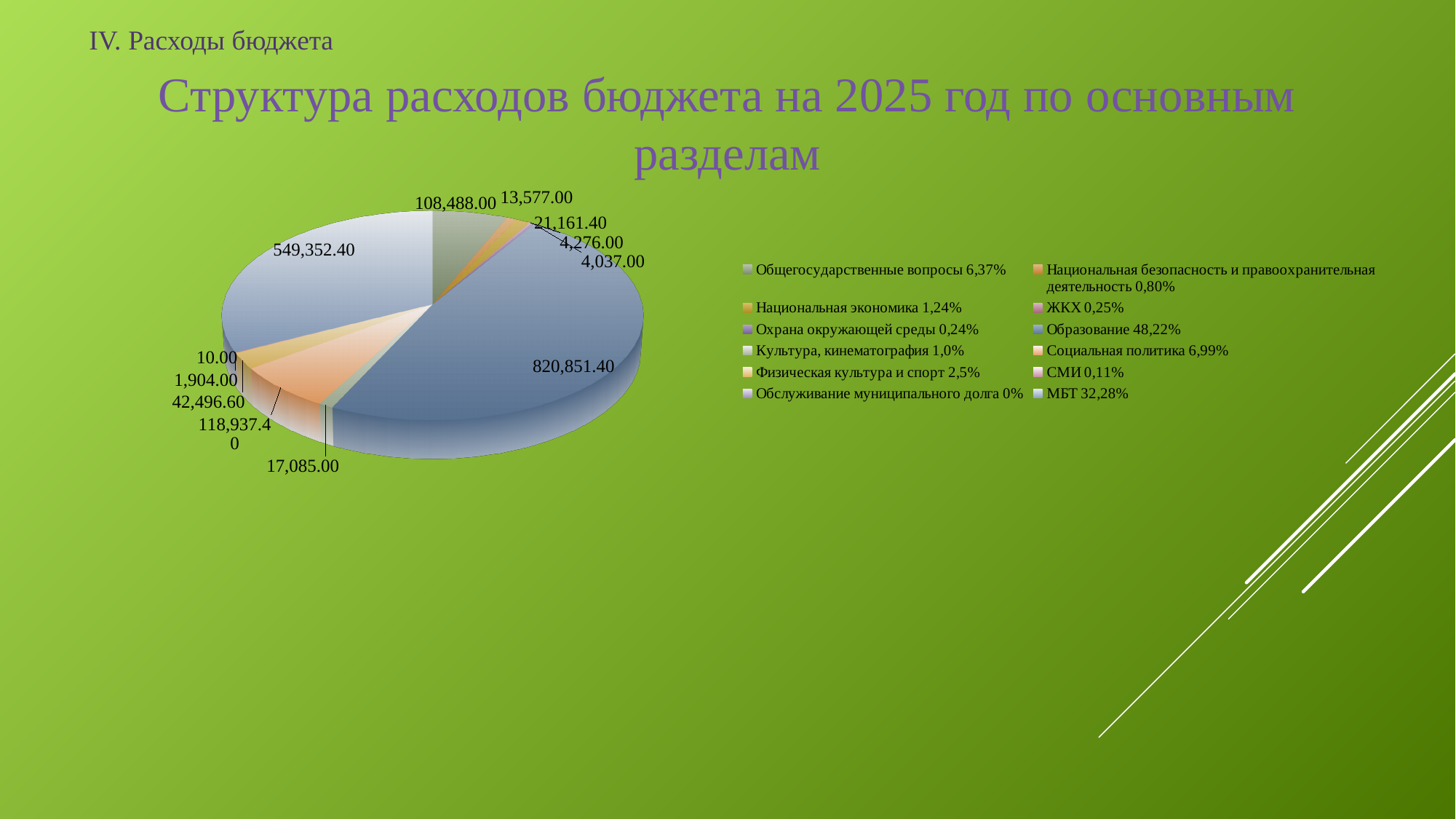
What share of the budget expenditure does Образование account for, according to the legend? 48,22% What is the value of the Образование slice? 820,851.40 What is the data label on the largest slice of the pie chart? 820,851.40 What share does Социальная политика account for, according to the legend? 6,99% What is the difference between the Образование slice (820,851.40) and the МБТ slice (549,352.40)? 271,499.00 What kind of chart is shown on the slide? Pie chart How many categories does the legend of the pie chart list? 12 What share does МБТ account for, according to the legend? 32,28% What is the data label on the smallest slice of the pie chart? 10.00 What is the value of the МБТ slice? 549,352.40 Which has a larger share according to the legend: Физическая культура и спорт or Национальная экономика? Физическая культура и спорт